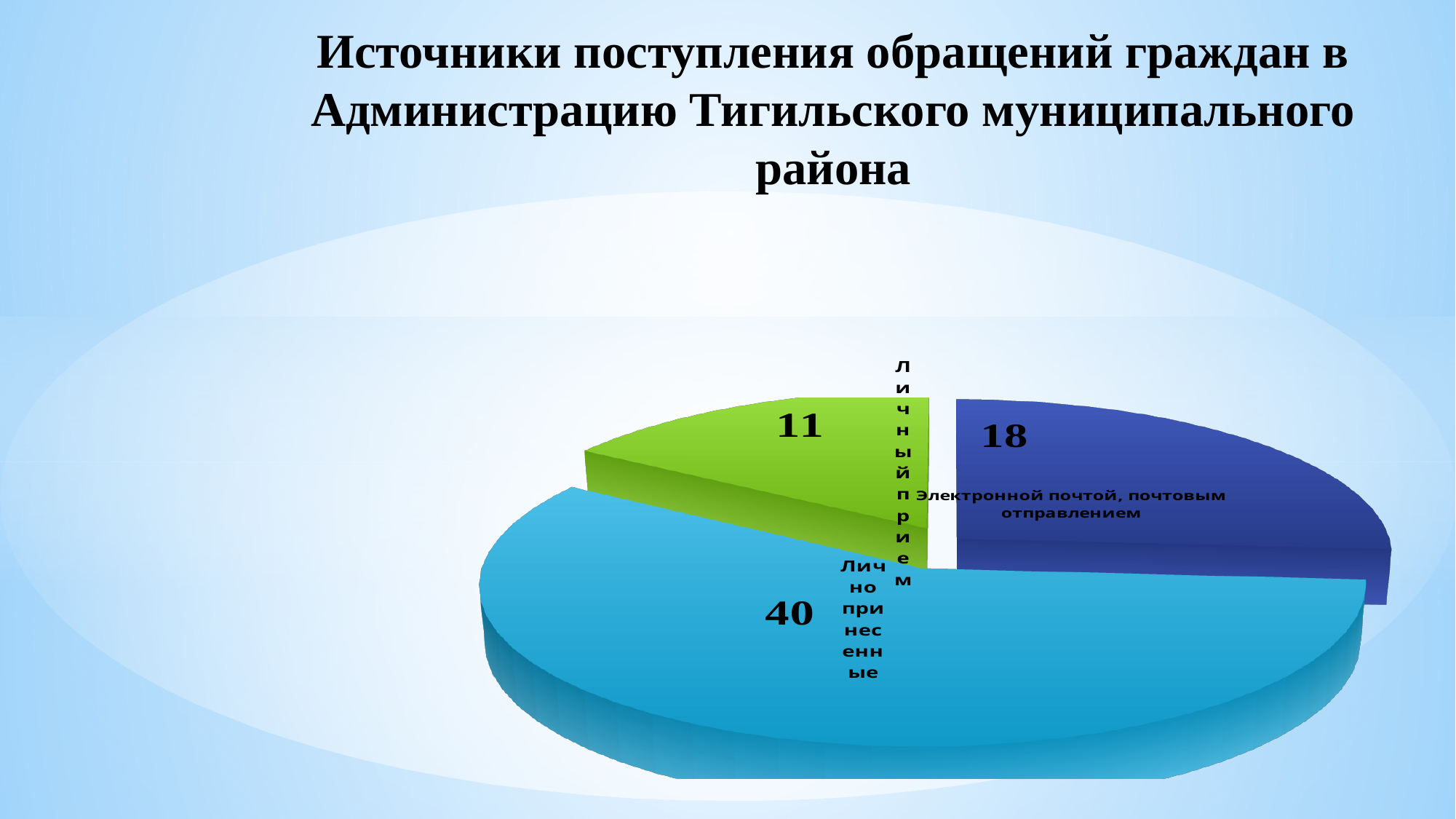
What is the difference between the values for "Электронной почтой, почтовым отправлением" and "Личный приём"? 7 What type of chart is shown on the slide? pie chart How many slices does the pie chart have? 3 Which source has the largest slice of the pie? Лично принесенные What colour is the slice for "Лично принесенные"? light blue Which source has the smallest slice of the pie? Личный приём What is the value for the slice "Лично принесенные"? 40 What is the total of all the slices in the pie chart? 69 What is the value for the slice "Личный приём"? 11 What is the difference between the values for "Лично принесенные" and "Электронной почтой, почтовым отправлением"? 22 What is the value for the slice "Электронной почтой, почтовым отправлением"? 18 Which is larger: the value for "Электронной почтой, почтовым отправлением" or the value for "Личный приём"? Электронной почтой, почтовым отправлением